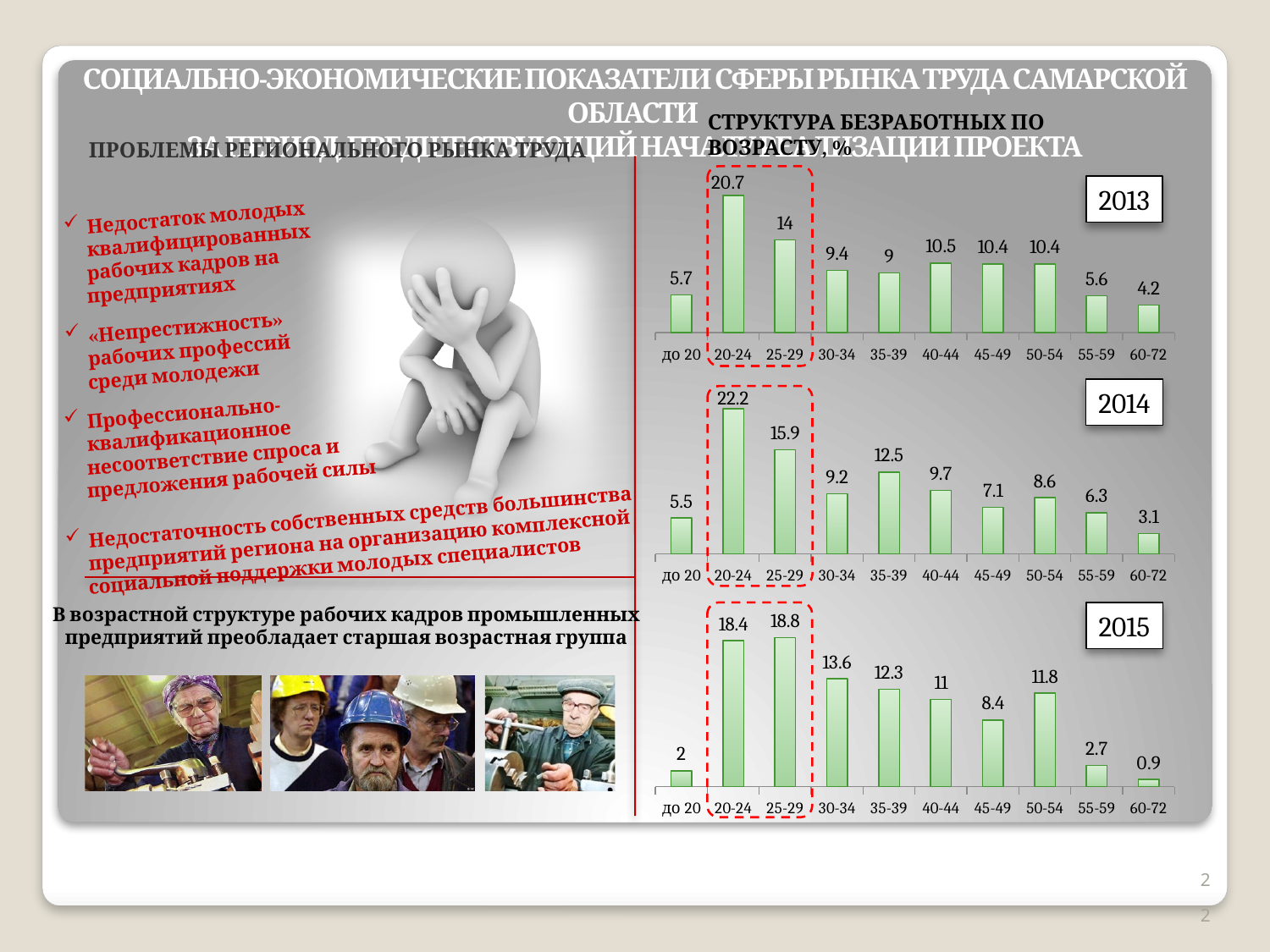
In the 2015 chart, which age group has the lowest value? 60-72 In the 2013 chart, which age group has the lowest value? 60-72 In the 2015 chart, which is larger: the value for 30-34 or the value for 45-49? 30-34 In the 2015 chart, what is the value for the 60-72 age group? 0.9 In the 2013 chart, what is the difference between the values for 20-24 and 25-29? 6.7 In the 2013 chart, what is the value for the 20-24 age group? 20.7 In the 2014 chart, what is the value for the 35-39 age group? 12.5 In the 2014 chart, what is the difference between the values for 25-29 and 30-34? 6.7 In the 2014 chart, which age group has the highest value? 20-24 What type of chart is used to show the structure of the unemployed by age for 2013? Bar chart How many age groups are shown in the 2015 chart? 10 In the 2015 chart, which is larger: the value for 20-24 or the value for 25-29? 25-29